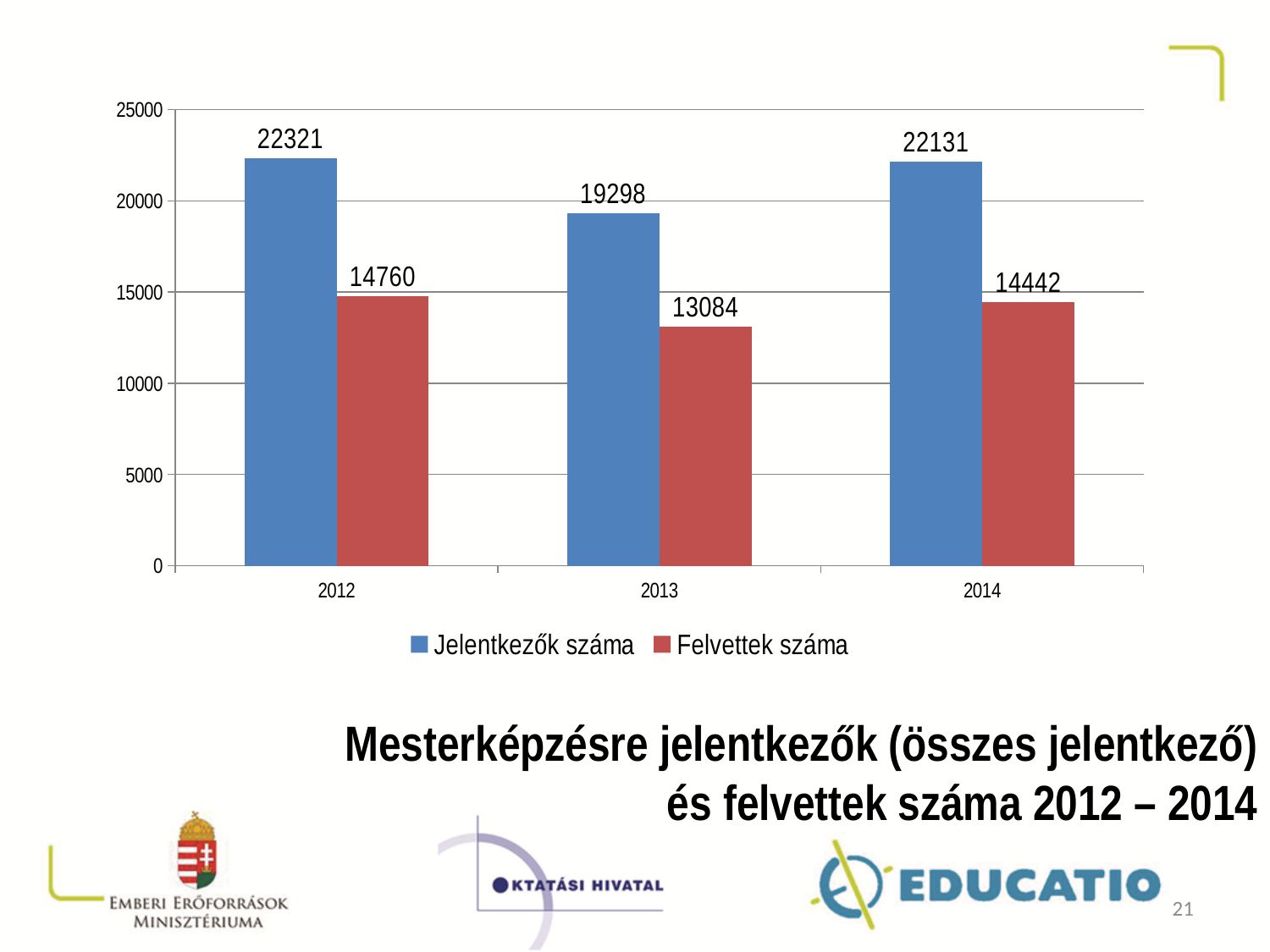
What is the difference between Jelentkezők száma in 2012 and in 2013? 3023 In which year is Jelentkezők száma the lowest? 2013 In which year is Felvettek száma the highest? 2012 What is the value of Felvettek száma for 2013? 13084 Is the value of Jelentkezők száma for 2013 greater or less than 20000? less How many years are shown on the x axis? 3 What is the value of Felvettek száma for 2014? 14442 What is the difference between Jelentkezők száma and Felvettek száma in 2014? 7689 How many series does the legend list? 2 Which is larger: Felvettek száma in 2012 or in 2014? 2012 What kind of chart is shown on the slide? bar chart What is the value of Jelentkezők száma for 2012? 22321